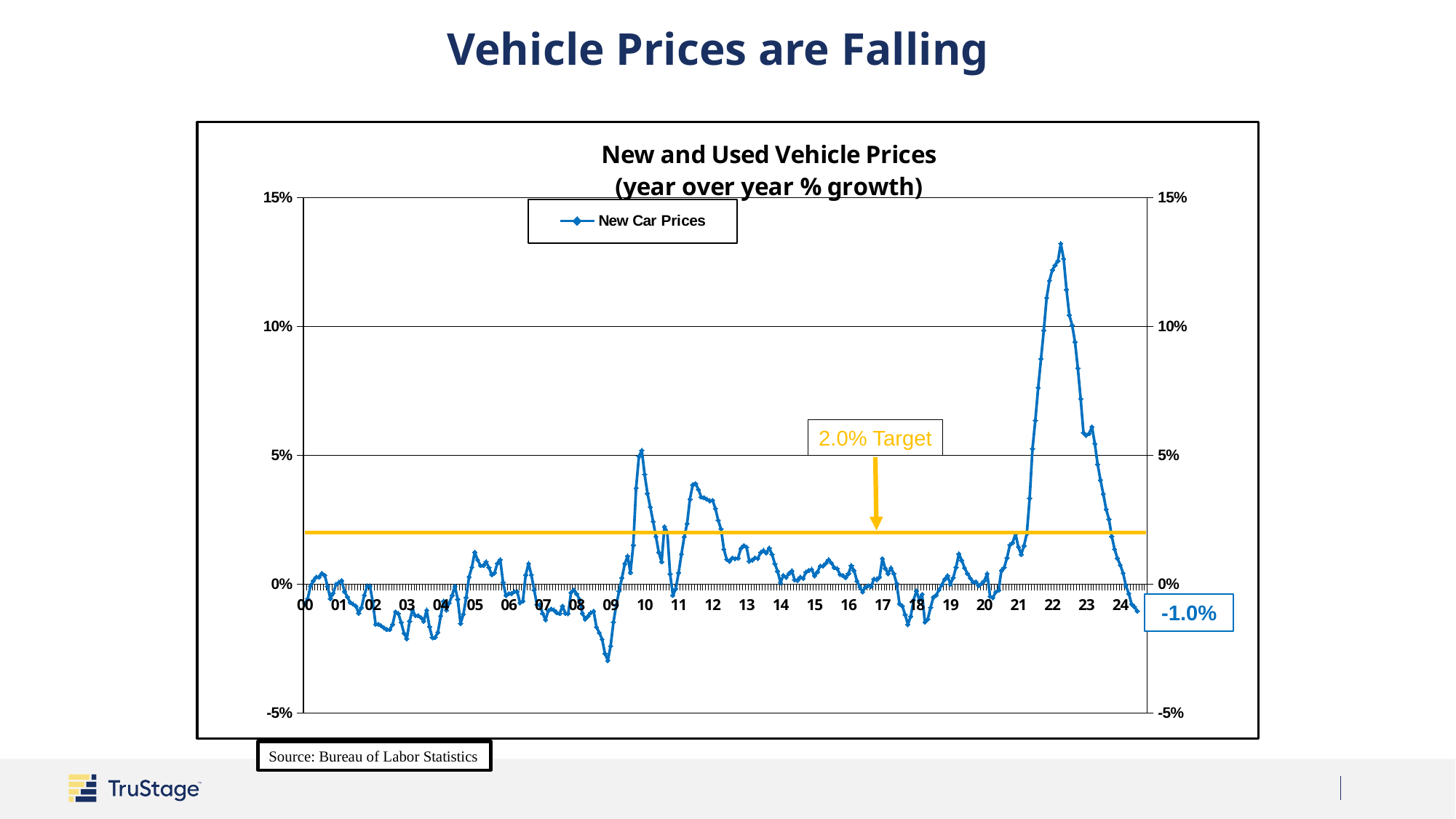
What is the most recent value shown for New Car Prices on the chart? -1.0% Which is larger: the peak of New Car Prices around 2010 or the peak around 2022? 2022 Does New Car Prices growth rise or fall from 2022 to 2024? Fall Is the lowest value for New Car Prices in 2009 greater or less than 0%? less How many year labels are shown on the x axis? 25 What is the title of the chart? New and Used Vehicle Prices (year over year % growth) How many series does the legend list? 1 What is the name of the series shown in the legend? New Car Prices What kind of chart is shown on the slide? Line chart What target level is marked by the horizontal line on the chart? 2.0% Target Is the peak value for New Car Prices in 2022 greater or less than 10%? greater In which year does New Car Prices growth reach its highest point? 22